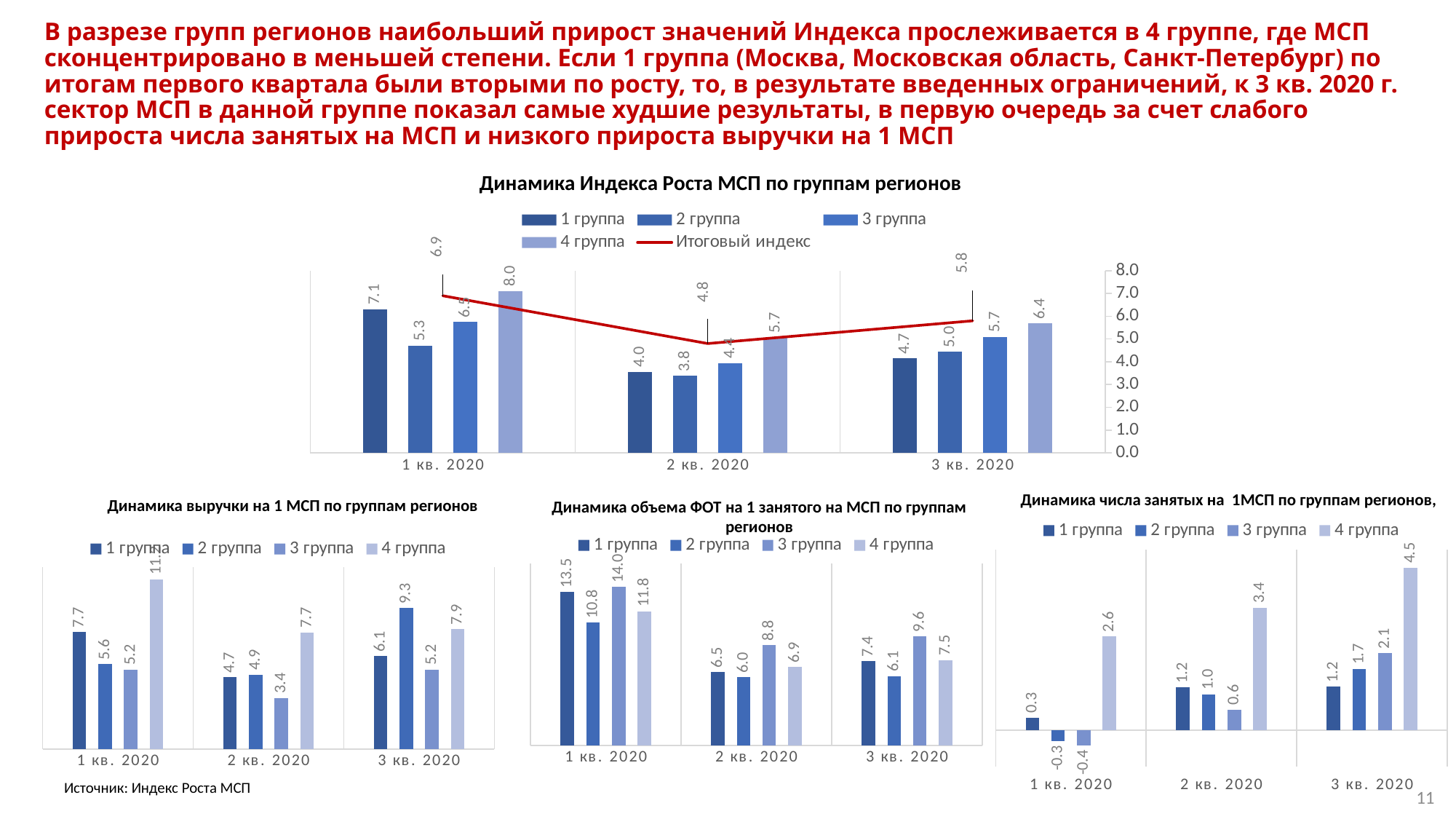
In the chart 'Динамика Индекса Роста МСП по группам регионов', what is the difference between 4 группа and 1 группа in 3 кв. 2020? 1.7 In the chart 'Динамика Индекса Роста МСП по группам регионов', which group has the lowest value in 2 кв. 2020? 2 группа In the chart 'Динамика выручки на 1 МСП по группам регионов', which group has the lowest value in 2 кв. 2020? 3 группа In the chart 'Динамика выручки на 1 МСП по группам регионов', what is the value for 2 группа in 3 кв. 2020? 9.3 In the chart 'Динамика числа занятых на 1МСП по группам регионов', how does the value for 4 группа change from 1 кв. 2020 to 3 кв. 2020? It rises In the chart 'Динамика объема ФОТ на 1 занятого на МСП по группам регионов', which group has the highest value in 1 кв. 2020? 3 группа In the chart 'Динамика числа занятых на 1МСП по группам регионов', what is the value for 3 группа in 1 кв. 2020? -0.4 In the chart 'Динамика Индекса Роста МСП по группам регионов', how many series does the legend list? 5 In the chart 'Динамика объема ФОТ на 1 занятого на МСП по группам регионов', what is the value for 2 группа in 2 кв. 2020? 6.0 In the chart 'Динамика Индекса Роста МСП по группам регионов', what is the value of Итоговый индекс in 2 кв. 2020? 4.8 In the chart 'Динамика Индекса Роста МСП по группам регионов', what is the value for 4 группа in 1 кв. 2020? 8.0 What kind of chart is 'Динамика числа занятых на 1МСП по группам регионов'? Bar chart